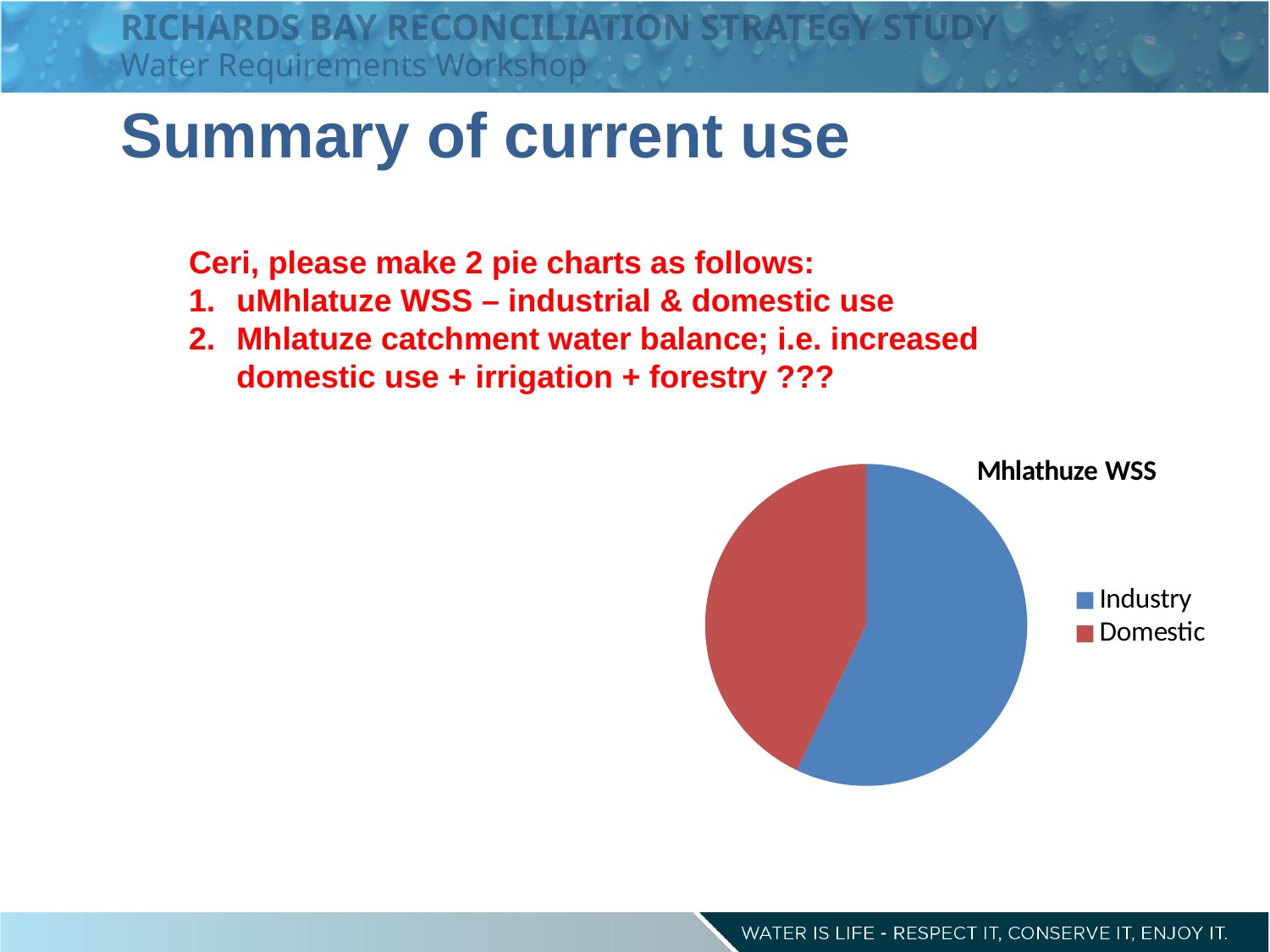
Which category has the largest slice in the pie chart? Industry How many entries does the legend of the pie chart list? 2 What is the title of the pie chart? Mhlathuze WSS What kind of chart is shown on the slide? pie chart How many slices does the pie chart have? 2 Which category has the smallest slice in the pie chart? Domestic What colour is the Domestic slice in the pie chart? red Which slice is larger in the pie chart, Industry or Domestic? Industry